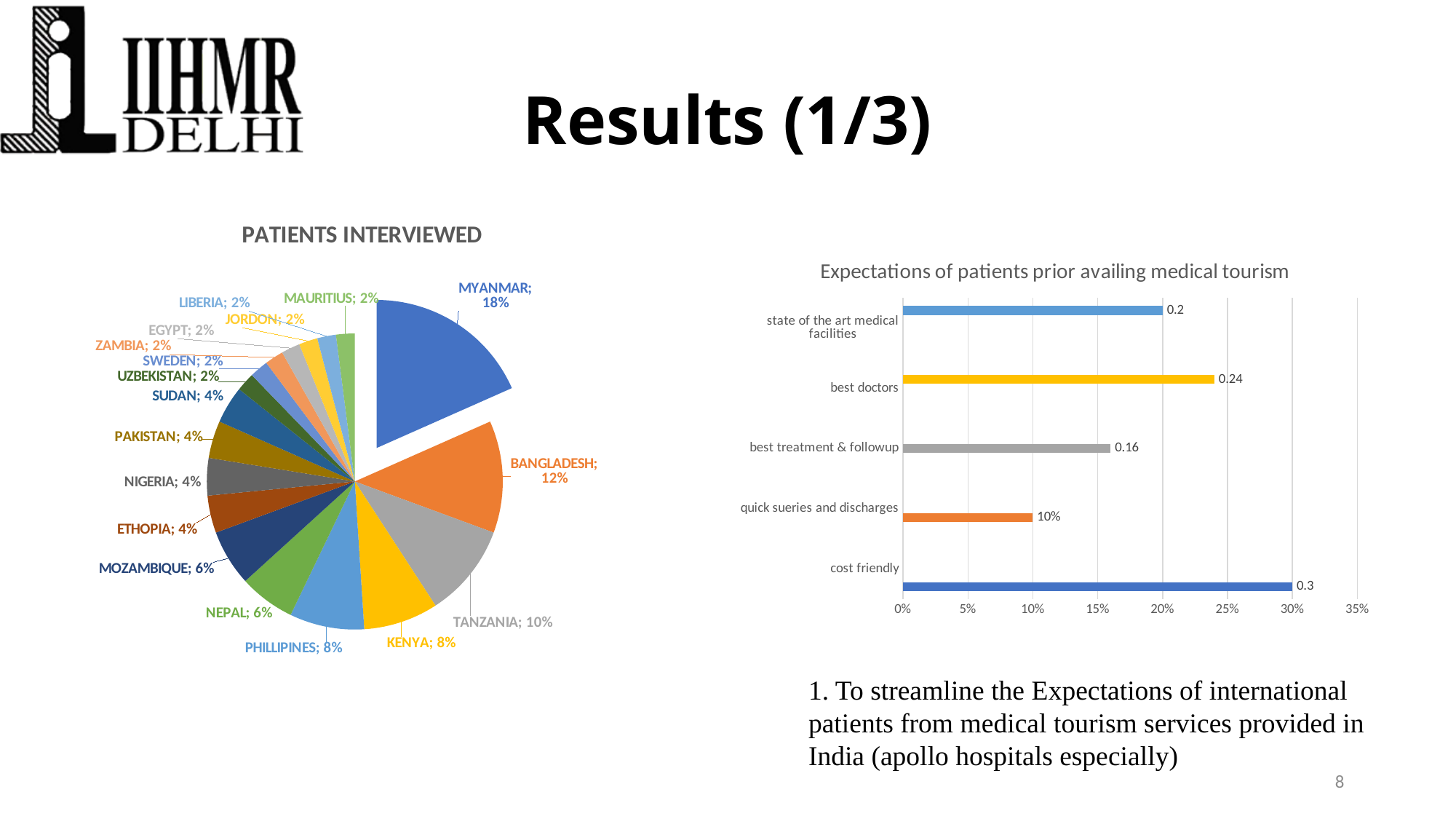
What type of chart is the PATIENTS INTERVIEWED chart? Pie chart In the Expectations of patients prior availing medical tourism chart, which category has the lowest value? quick sueries and discharges In the PATIENTS INTERVIEWED pie chart, what is the difference between the Myanmar and Bangladesh shares? 6% In the PATIENTS INTERVIEWED pie chart, what share of patients were from Tanzania? 10% How many countries are shown in the PATIENTS INTERVIEWED pie chart? 18 In the Expectations of patients prior availing medical tourism chart, what is the value for quick sueries and discharges? 10% In the PATIENTS INTERVIEWED pie chart, which country has the largest slice? Myanmar In the Expectations of patients prior availing medical tourism chart, which category has the highest value? cost friendly In the PATIENTS INTERVIEWED pie chart, which is larger, the Kenya slice or the Nepal slice? Kenya In the Expectations of patients prior availing medical tourism chart, what is the value for best doctors? 0.24 In the PATIENTS INTERVIEWED pie chart, what share of patients were from Myanmar? 18% What type of chart is the Expectations of patients prior availing medical tourism chart? Bar chart